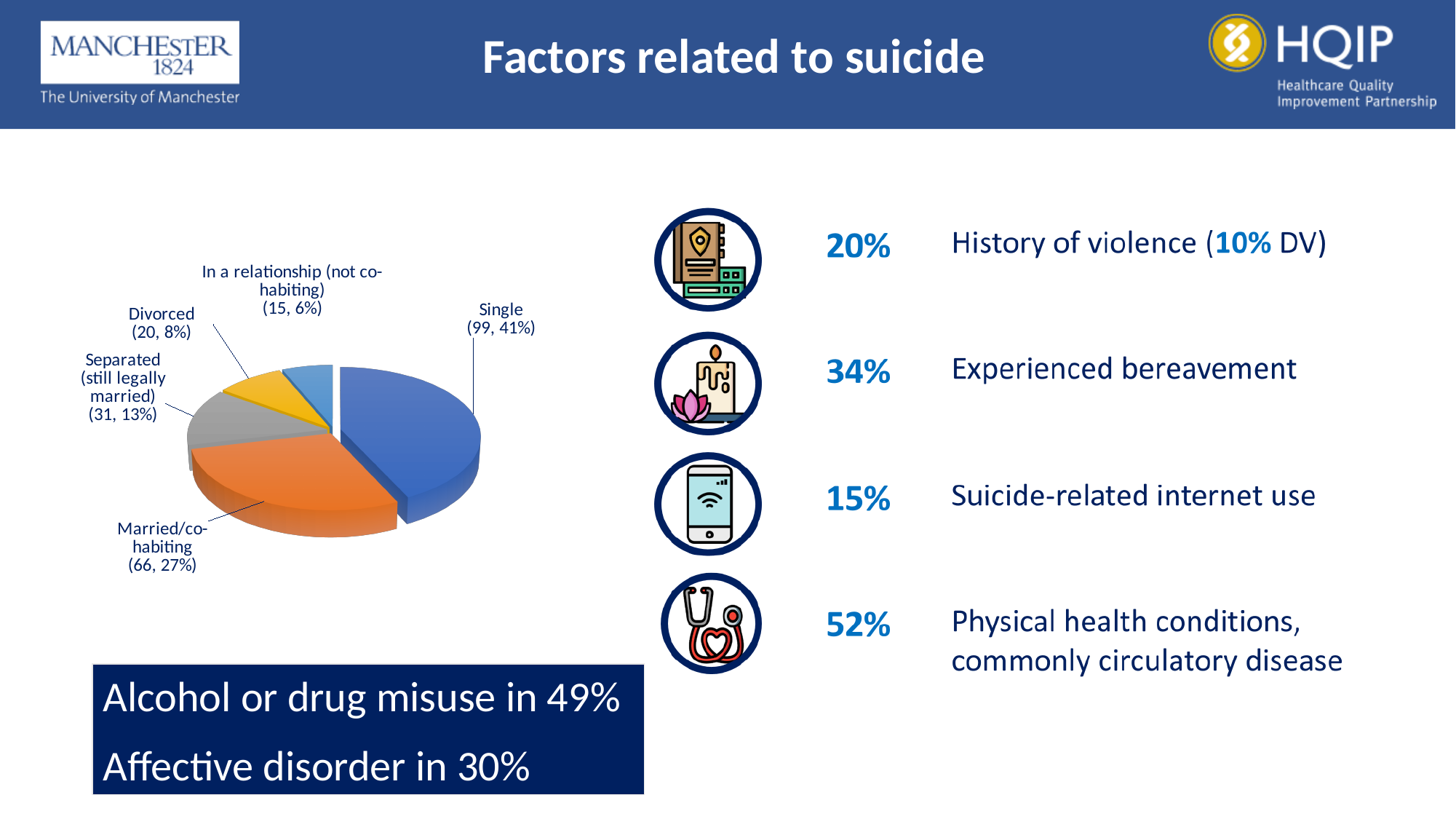
Which slice is larger, Divorced or Separated (still legally married)? Separated (still legally married) What is the count for the Single slice of the pie chart? 99 What percentage does the Divorced slice represent? 8% What colour is the Married/co-habiting slice of the pie chart? Orange What kind of chart is shown on the slide? Pie chart Which category has the smallest slice in the pie chart? In a relationship (not co-habiting) How many categories does the pie chart show? 5 Which category has the largest slice in the pie chart? Single What is the count for the In a relationship (not co-habiting) slice? 15 What is the count for the Separated (still legally married) slice? 31 What is the difference in count between the Single and Married/co-habiting slices? 33 What percentage of the pie chart is the Married/co-habiting slice? 27%